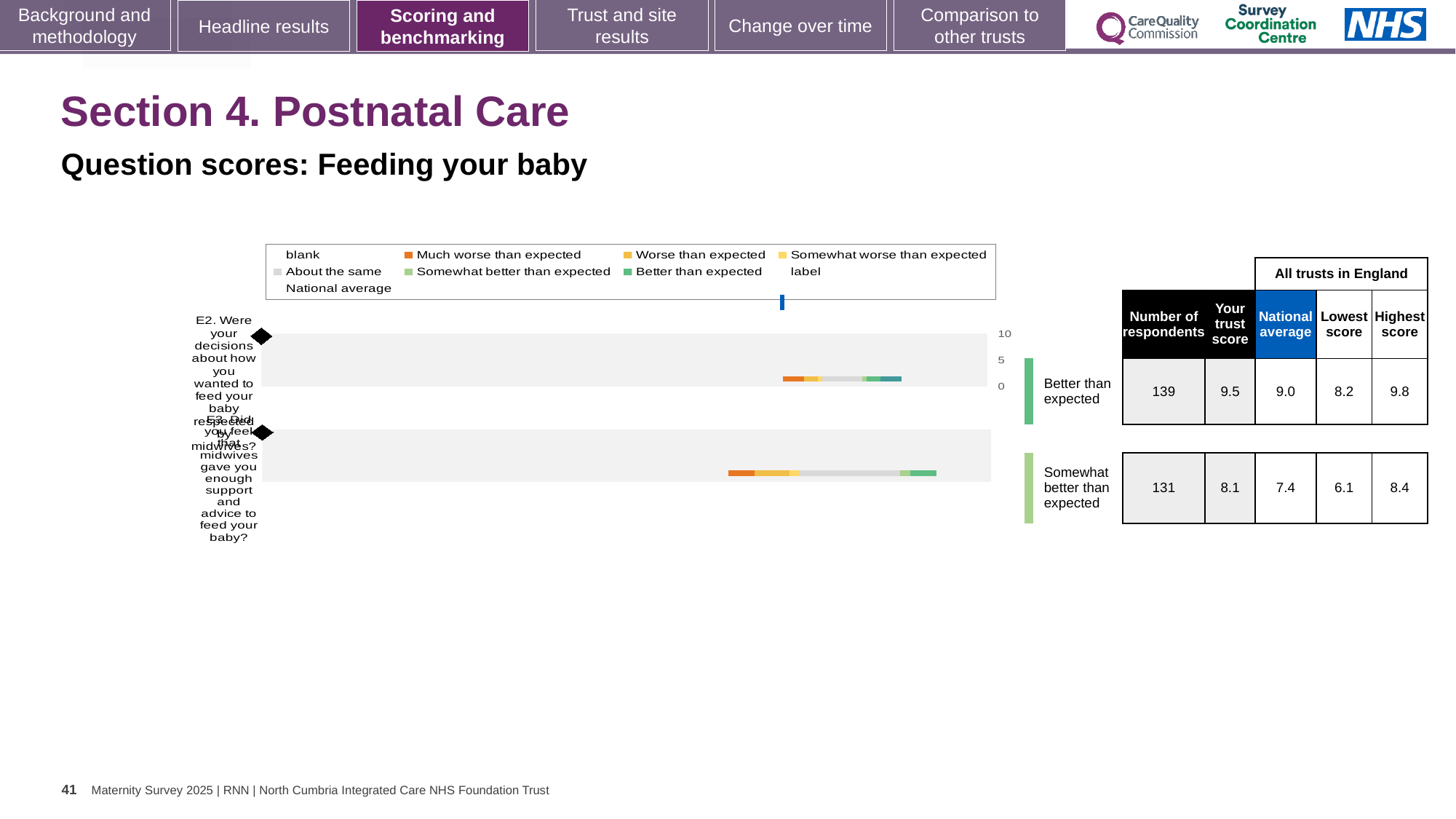
What is the national average for E3 (midwives gave you enough support and advice to feed your baby)? 7.4 How many respondents answered question E2? 139 How many questions are plotted in the Feeding your baby chart? 2 Which benchmark category is shown for question E2? Better than expected Which question has the higher trust score, E2 or E3? E2 By how much does the trust score for E2 exceed the national average for E2? 0.5 What is the difference between the highest and lowest scores for question E3? 2.3 What is the trust score for E2 (decisions about how you wanted to feed your baby respected by midwives)? 9.5 What is the lowest score among all trusts in England for question E2? 8.2 Which benchmark category is shown for question E3? Somewhat better than expected What kind of chart is used to show the question scores for Feeding your baby? bar chart What is the highest score among all trusts in England for question E3? 8.4